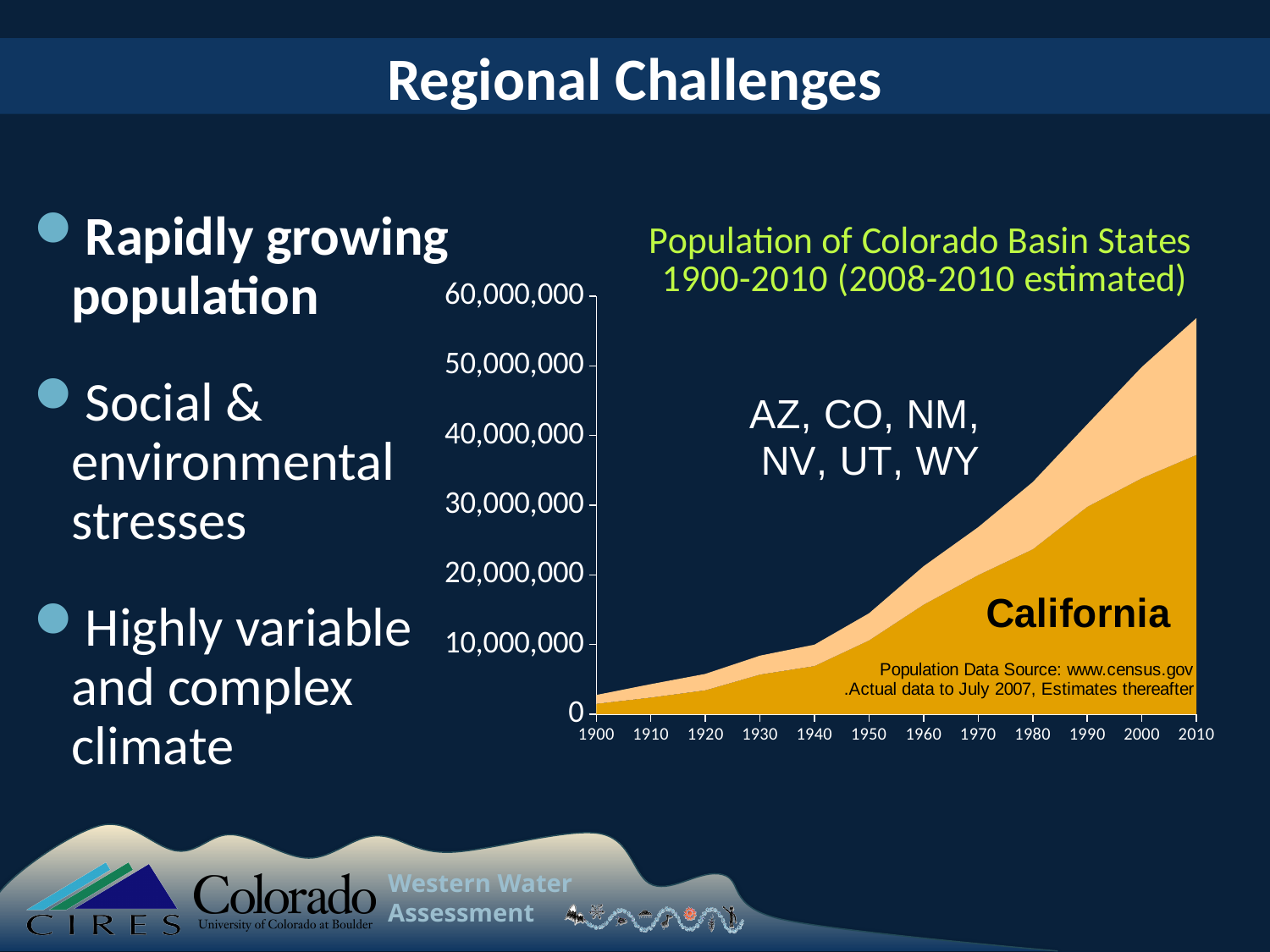
Is the population of California in 1900 greater or less than 10,000,000? less In 2010, which is larger: the population of California or the combined population of AZ, CO, NM, NV, UT, WY? California In which year is the total population lowest? 1900 Does the total population rise or fall from 1900 to 2010? Rises Is the population of California in 2010 greater or less than 30,000,000? greater How many series (areas) does the chart show? 2 In which year is the total population highest? 2010 What kind of chart is shown on the slide? Stacked area chart What is the title of the chart? Population of Colorado Basin States 1900-2010 (2008-2010 estimated) Which series is shown in the darker orange area at the bottom of the chart? California How many year labels are shown on the x axis? 12 Is the total population of the basin states in 2010 greater or less than 50,000,000? greater